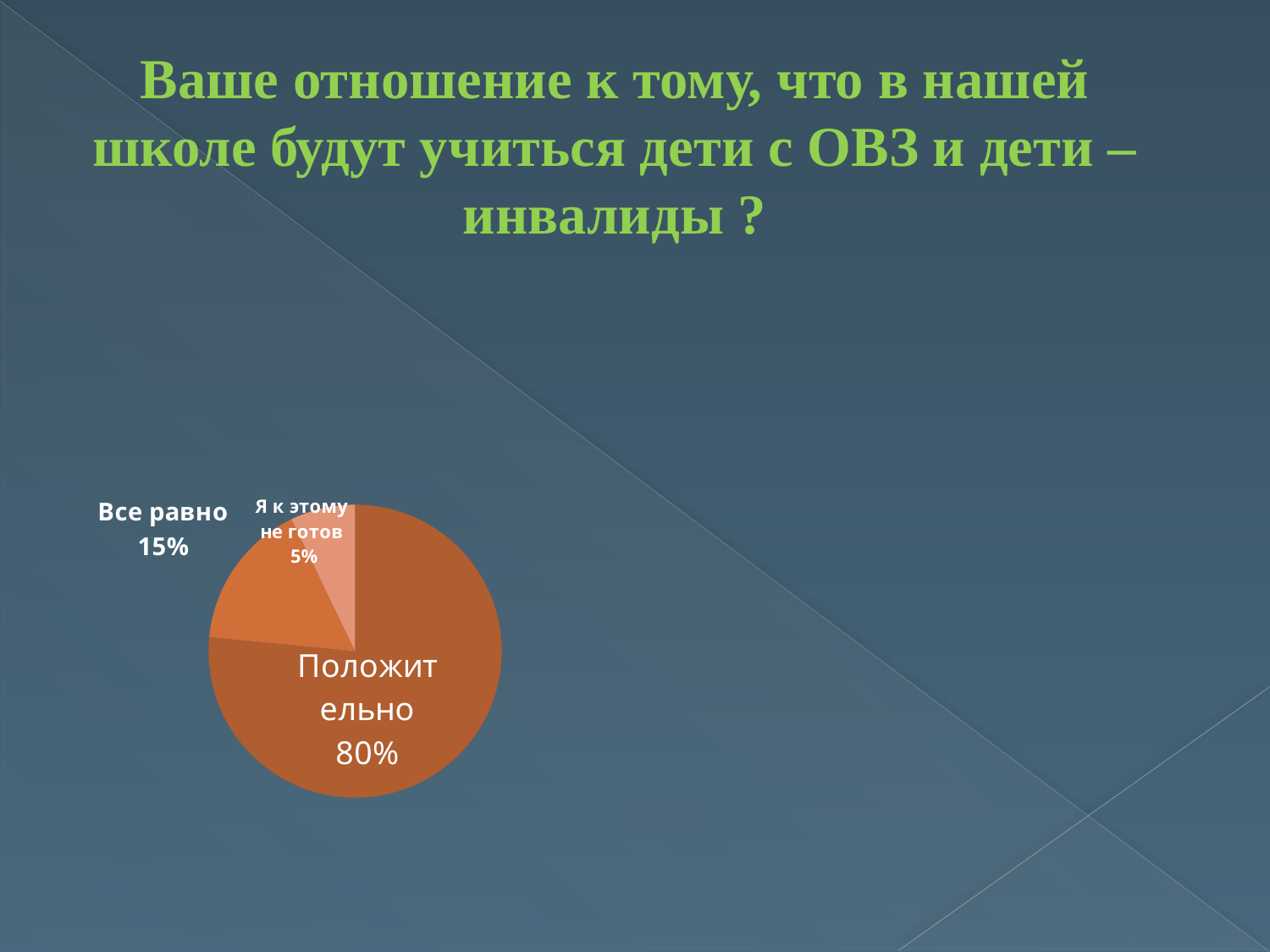
Which slice of the pie is the largest? Положительно What is the combined share of "Все равно" and "Я к этому не готов"? 20% Which is larger, the share for "Все равно" or the share for "Я к этому не готов"? Все равно What is the difference between the shares for "Положительно" and "Все равно"? 65% Which slice of the pie is the smallest? Я к этому не готов What is the title of the slide above the pie chart? Ваше отношение к тому, что в нашей школе будут учиться дети с ОВЗ и дети – инвалиды ? What share of the pie does "Я к этому не готов" have? 5% What share of the pie does "Положительно" have? 80% What kind of chart is shown on the slide? pie chart What is the difference between the shares for "Все равно" and "Я к этому не готов"? 10% How many slices does the pie chart have? 3 What share of the pie does "Все равно" have? 15%